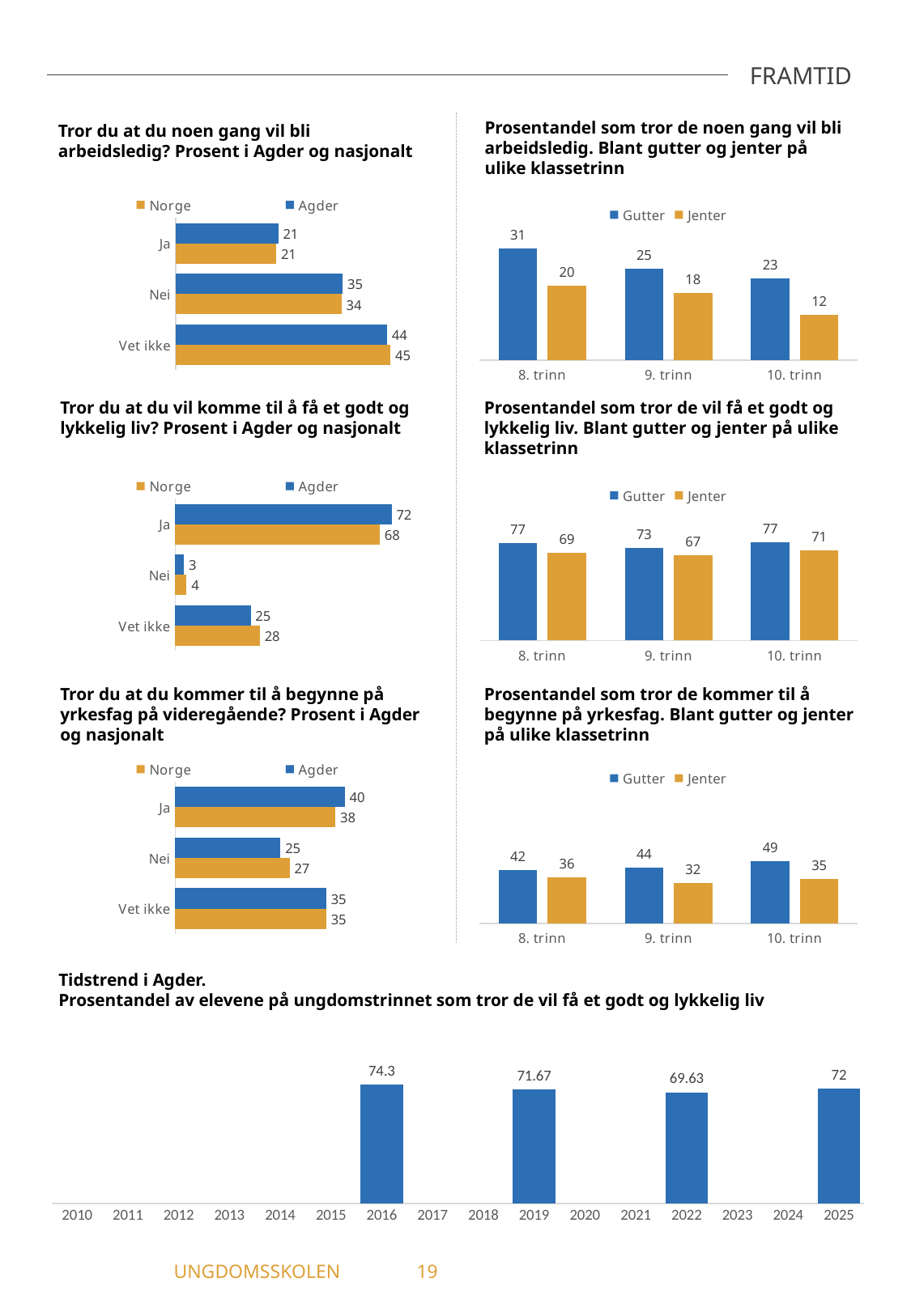
In the chart 'Prosentandel som tror de vil få et godt og lykkelig liv. Blant gutter og jenter på ulike klassetrinn', what is the difference between Gutter and Jenter in 9. trinn? 6 In the chart 'Tror du at du noen gang vil bli arbeidsledig? Prosent i Agder og nasjonalt', what is the value for Agder for 'Vet ikke'? 44 In the chart 'Tror du at du kommer til å begynne på yrkesfag på videregående? Prosent i Agder og nasjonalt', what is the value for Agder for 'Nei'? 25 In the chart 'Prosentandel som tror de noen gang vil bli arbeidsledig. Blant gutter og jenter på ulike klassetrinn', what is the value for Jenter in 10. trinn? 12 In the chart 'Tror du at du vil komme til å få et godt og lykkelig liv? Prosent i Agder og nasjonalt', what is the value for Norge for 'Ja'? 68 In the chart 'Tidstrend i Agder', which year has the lowest value? 2022 In the chart 'Prosentandel som tror de kommer til å begynne på yrkesfag. Blant gutter og jenter på ulike klassetrinn', which grade has the lowest value for Jenter? 9. trinn In the chart 'Tror du at du noen gang vil bli arbeidsledig? Prosent i Agder og nasjonalt', what is the difference between the Norge and Agder values for 'Nei'? 1 In the chart 'Prosentandel som tror de noen gang vil bli arbeidsledig. Blant gutter og jenter på ulike klassetrinn', which grade has the highest value for Gutter? 8. trinn In the chart 'Tidstrend i Agder', what is the value for 2019? 71.67 In the chart 'Tror du at du vil komme til å få et godt og lykkelig liv? Prosent i Agder og nasjonalt', which is larger for 'Vet ikke': Norge or Agder? Norge In the chart 'Prosentandel som tror de kommer til å begynne på yrkesfag. Blant gutter og jenter på ulike klassetrinn', how many series does the legend list? 2